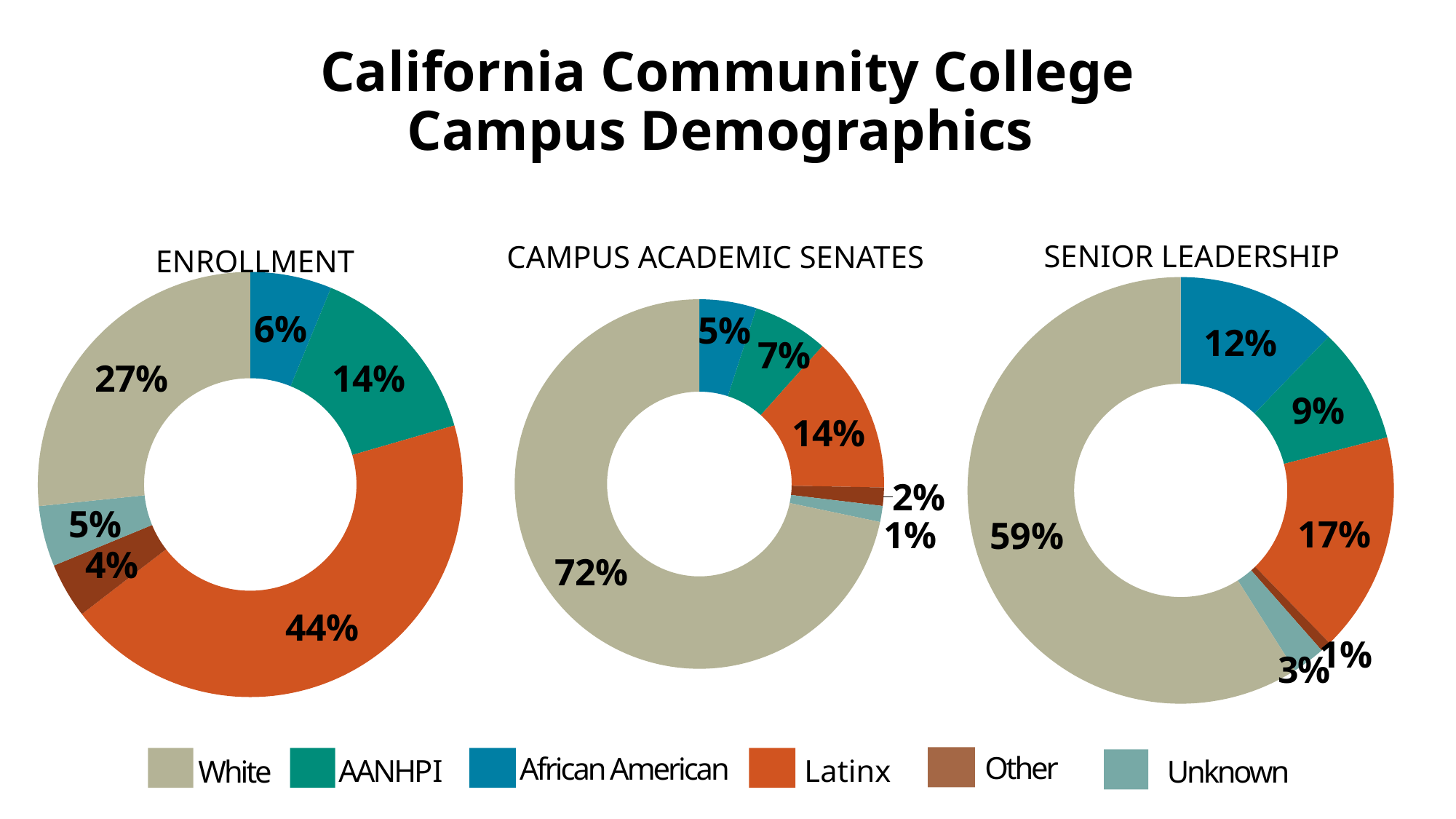
In the Enrollment chart, what is the difference between the White share and the AANHPI share? 13% In the Campus Academic Senates chart, which group has the smallest share? Unknown In the Senior Leadership chart, what share is Latinx? 17% In the Senior Leadership chart, which group has the largest share? White How many groups does the legend list? 6 In the Senior Leadership chart, what share is African American? 12% Is the White share larger in the Campus Academic Senates chart or the Senior Leadership chart? Campus Academic Senates In the Campus Academic Senates chart, what share is White? 72% What colour represents Latinx in the legend? Orange In the Enrollment chart, which group has the largest share? Latinx In the Enrollment chart, what share is Latinx? 44% What kind of chart is used for the Enrollment data? Donut (pie) chart